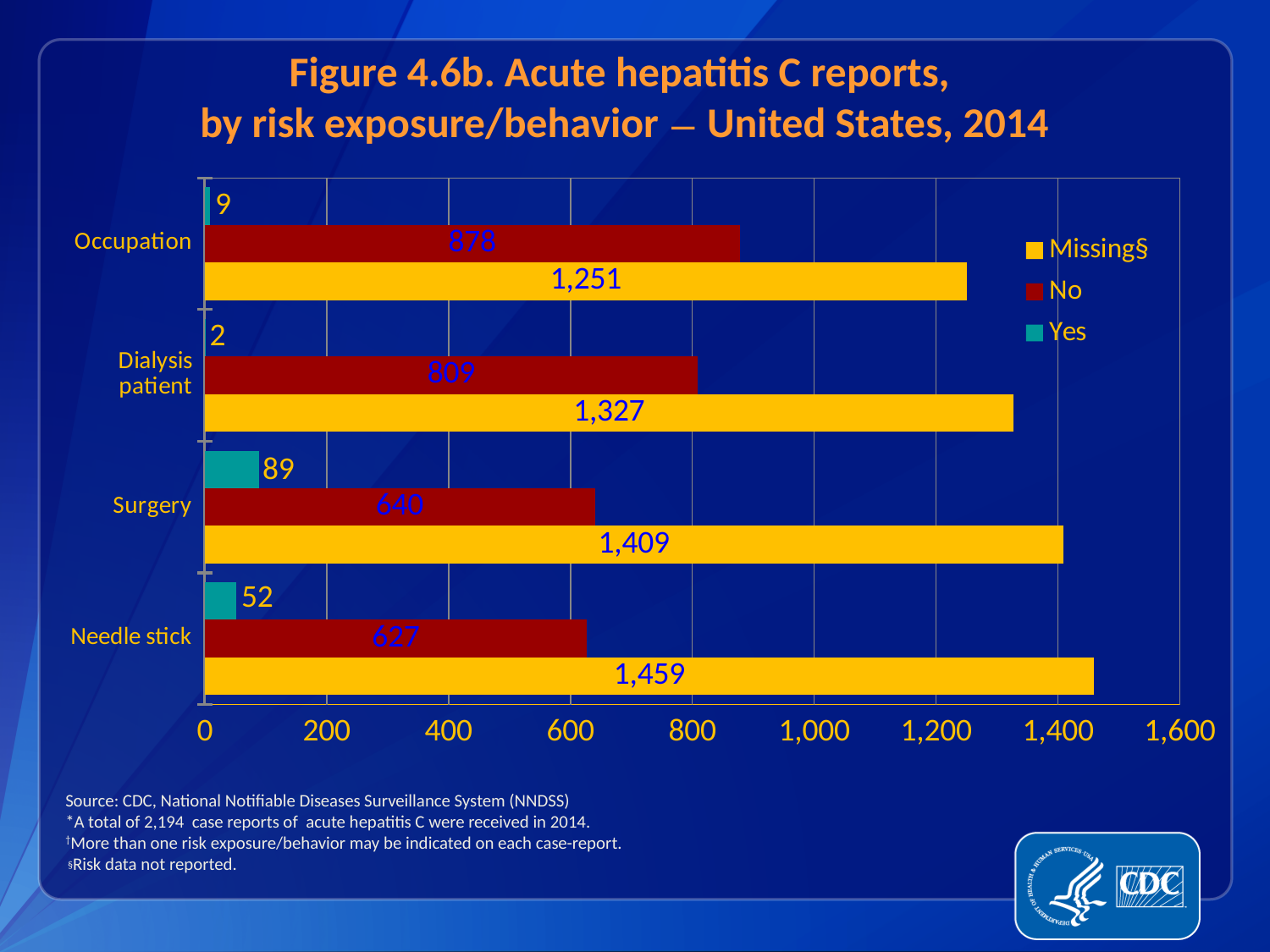
What kind of chart is shown on the slide? Bar chart How many series does the legend list? 3 How many categories are shown on the y axis? 4 Which is larger, the No value for Dialysis patient or the No value for Surgery? Dialysis patient Which colour represents the Yes series in the legend? Teal What is the value of the No series for Occupation? 878 What is the value of the Missing§ series for Needle stick? 1,459 What is the value of the Yes series for Surgery? 89 Which category has the lowest value in the Yes series? Dialysis patient What is the difference between the Missing§ values for Surgery and Occupation? 158 What is the value of the Yes series for Dialysis patient? 2 Which category has the highest value in the Missing§ series? Needle stick